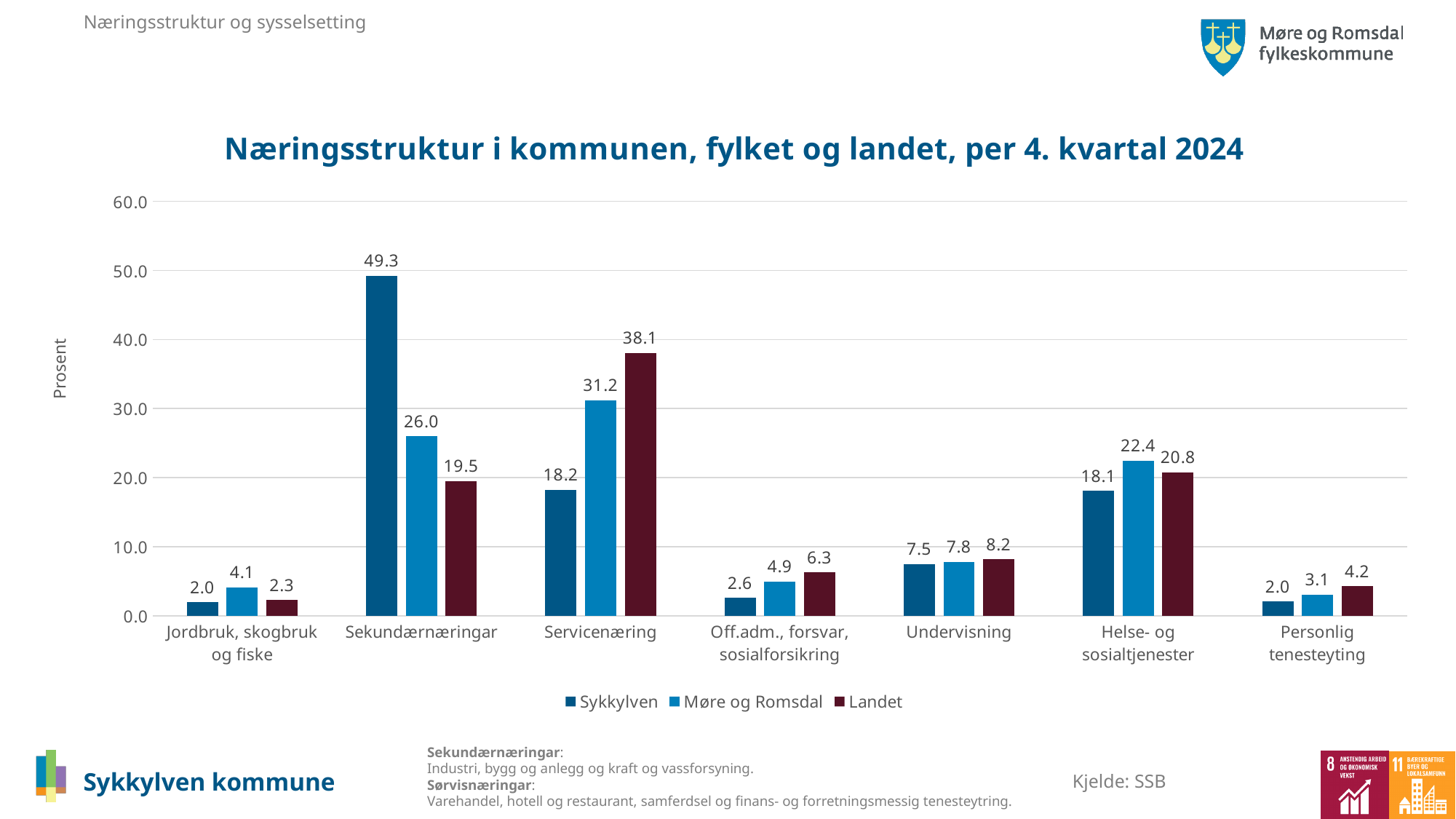
How many series does the legend list? 3 Which category has the lowest value for Landet? Jordbruk, skogbruk og fiske What is the difference between Sykkylven and Landet in Sekundærnæringar? 29.8 Which is larger in Servicenæring: Sykkylven or Møre og Romsdal? Møre og Romsdal Which category has the highest value for Sykkylven? Sekundærnæringar What kind of chart is shown? Bar chart What is the title of the chart? Næringsstruktur i kommunen, fylket og landet, per 4. kvartal 2024 How many categories are shown on the x axis? 7 What is the label on the y axis? Prosent What is the value for Landet in Servicenæring? 38.1 What is the value for Møre og Romsdal in Helse- og sosialtjenester? 22.4 What is the value for Sykkylven in Sekundærnæringar? 49.3